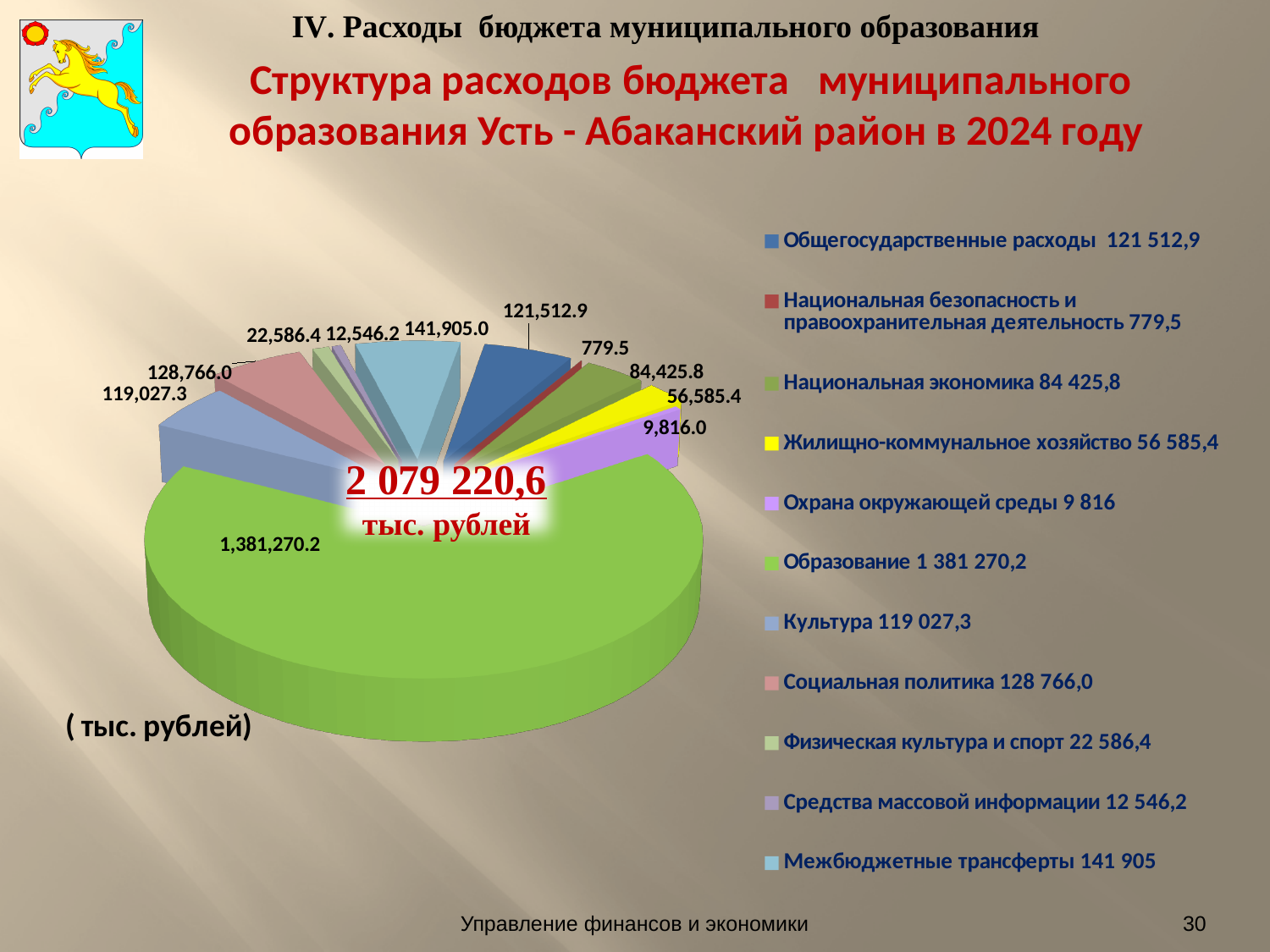
Which category has the largest slice of the pie? Образование What is the value for Образование? 1,381,270.2 How many categories does the pie chart show? 11 What is the value for Межбюджетные трансферты? 141,905.0 What colour is the Образование slice? Green What is the value for Жилищно-коммунальное хозяйство? 56,585.4 What is the total shown in the centre of the pie chart? 2 079 220,6 тыс. рублей Which category has the smallest slice of the pie? Национальная безопасность и правоохранительная деятельность How many entries does the legend list? 11 Which is larger, Культура or Социальная политика? Социальная политика What is the difference between Общегосударственные расходы and Национальная экономика? 37,087.1 What kind of chart is shown on the slide? Pie chart